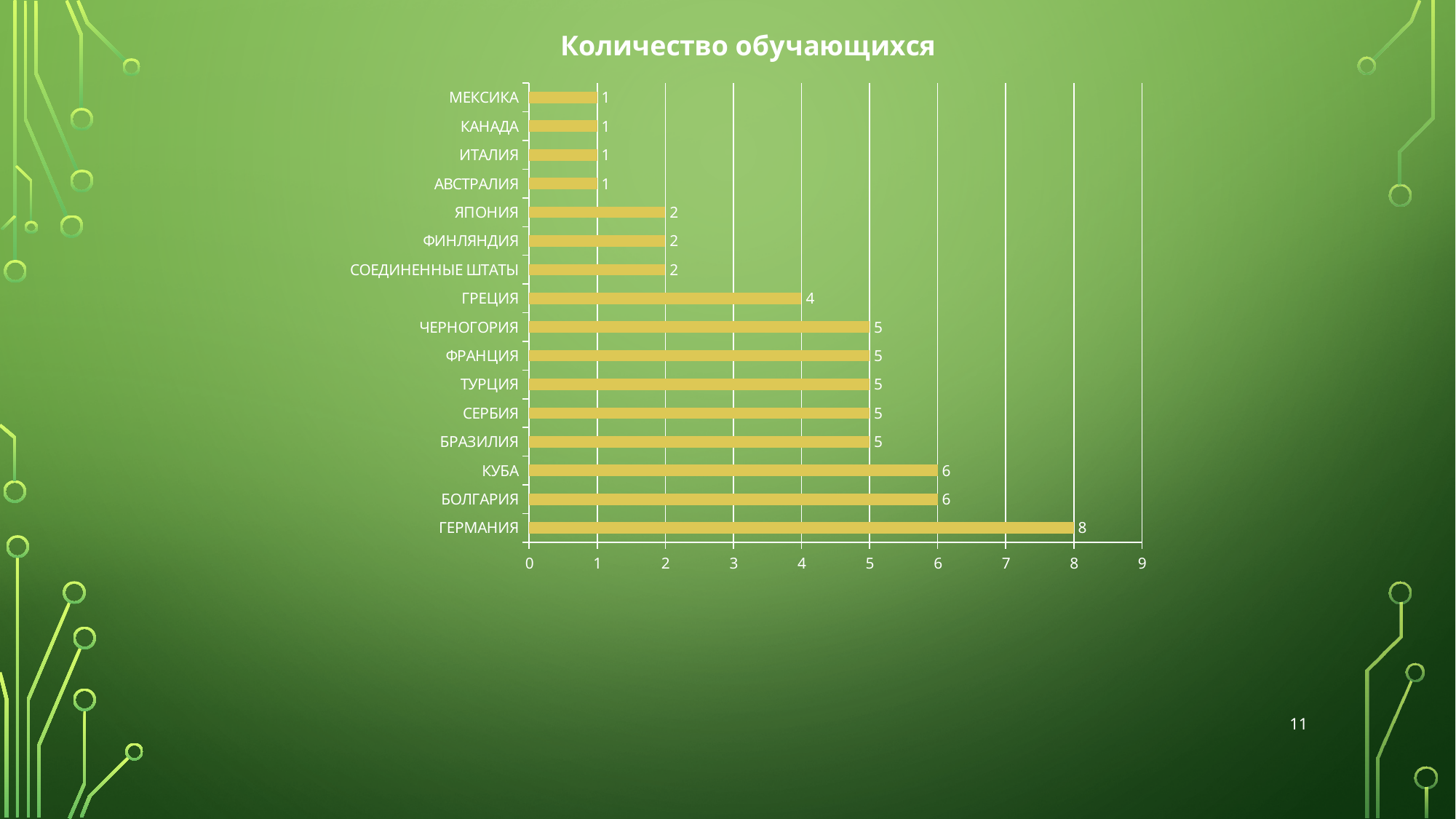
How many categories are shown on the chart? 16 What is the value for ГРЕЦИЯ? 4 What is the value for ГЕРМАНИЯ? 8 Is the value for ГЕРМАНИЯ greater or less than 7? greater What is the difference between the values for ЧЕРНОГОРИЯ and ФИНЛЯНДИЯ? 3 What is the difference between the values for ГЕРМАНИЯ and КУБА? 2 What kind of chart is shown on the slide? bar chart What is the value for ЯПОНИЯ? 2 How many categories have a value of 5? 5 What is the title of the chart? Количество обучающихся Which is larger, the value for БОЛГАРИЯ or the value for ГРЕЦИЯ? БОЛГАРИЯ Which category has the highest value? ГЕРМАНИЯ